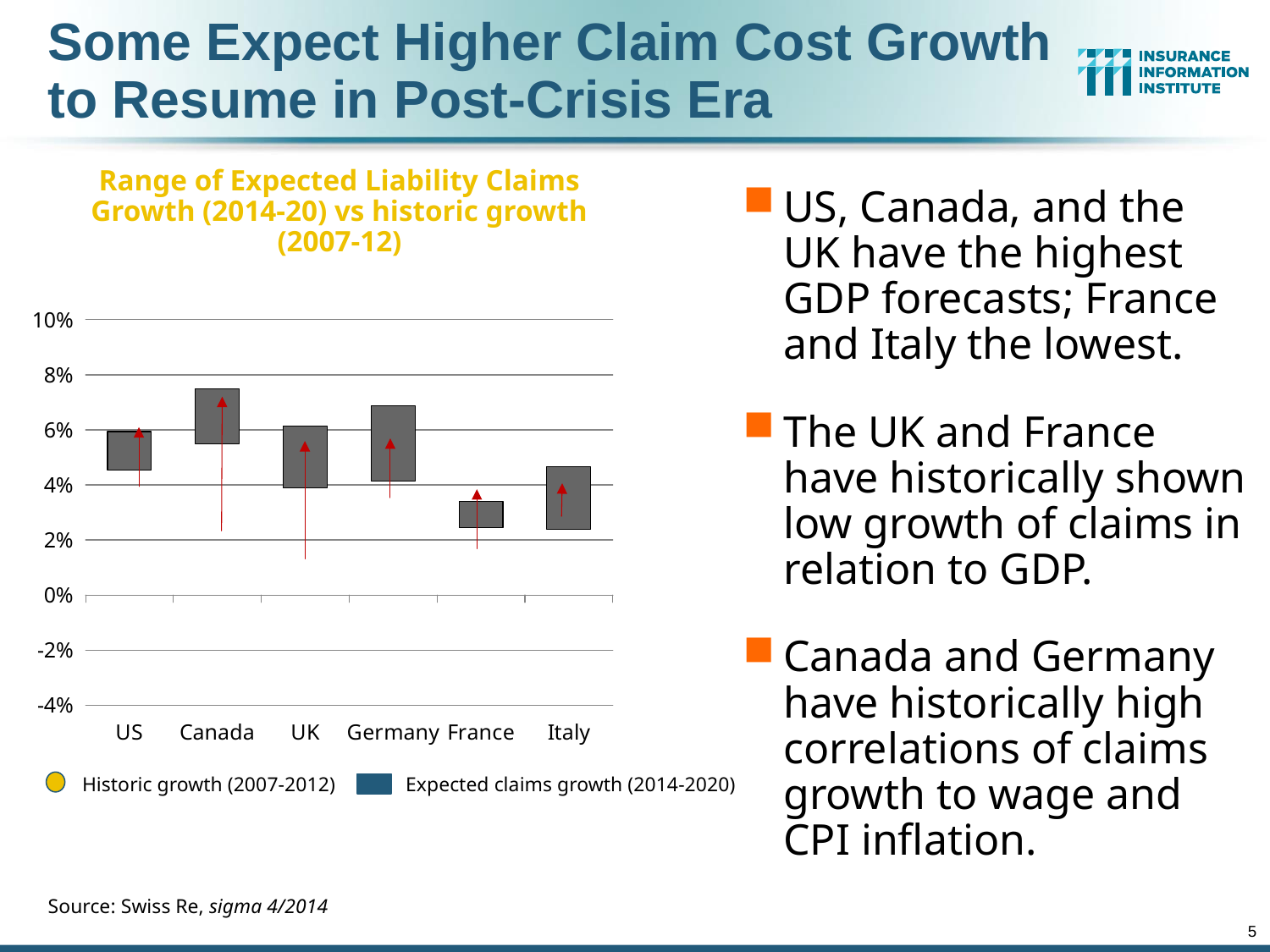
Is the top of the expected claims growth range for Canada greater or less than 6%? greater Is the bottom of the expected claims growth range for Canada greater or less than 4%? greater How many entries does the chart's legend list? 2 What kind of chart is shown on the slide? bar chart Is the top of the expected claims growth range for Italy greater or less than 6%? less Which country has the highest top of its expected claims growth range? Canada Which country has the lowest expected claims growth range? France What does the second legend entry of the chart say? Expected claims growth (2014-2020) How many countries are shown on the x axis of the chart? 6 Which country has a higher top of its expected claims growth range, Canada or France? Canada What is the title of the chart? Range of Expected Liability Claims Growth (2014-20) vs historic growth (2007-12)